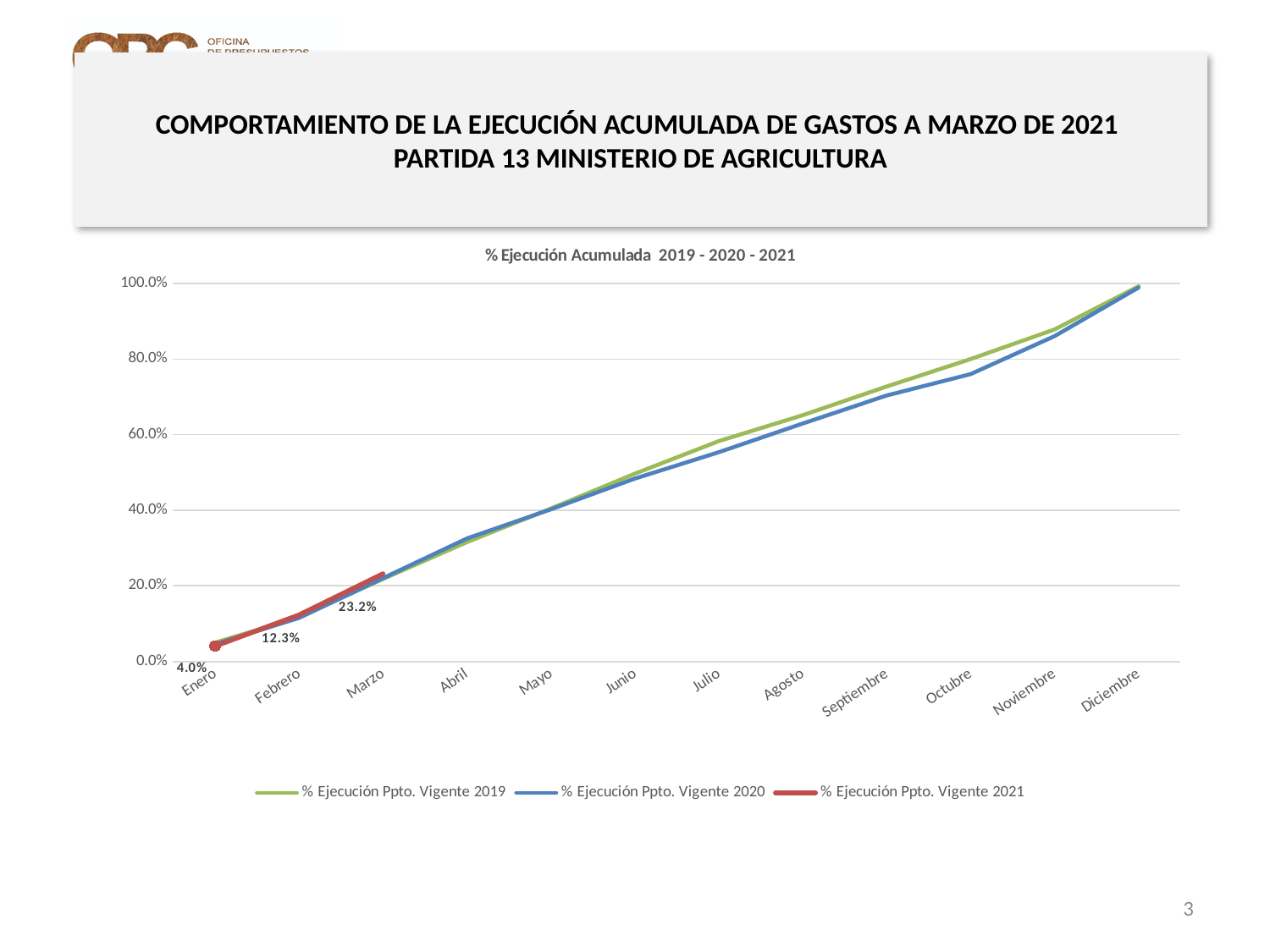
What is the value for Enero in the % Ejecución Ppto. Vigente 2021 series? 4.0% Do the values of the % Ejecución Ppto. Vigente 2020 series rise or fall from Enero to Diciembre? Rise What is the value for Febrero in the % Ejecución Ppto. Vigente 2021 series? 12.3% What is the difference between the Febrero and Enero values of the % Ejecución Ppto. Vigente 2021 series? 8.3 percentage points What is the title of the chart? % Ejecución Acumulada 2019 - 2020 - 2021 What is the difference between the Marzo and Febrero values of the % Ejecución Ppto. Vigente 2021 series? 10.9 percentage points Which month has the highest value in the % Ejecución Ppto. Vigente 2021 series? Marzo Is the value for Octubre in the % Ejecución Ppto. Vigente 2020 series greater or less than 80.0%? less How many series does the legend list? 3 What kind of chart is shown on the slide? Line chart How many months are shown on the x axis? 12 What is the value for Marzo in the % Ejecución Ppto. Vigente 2021 series? 23.2%